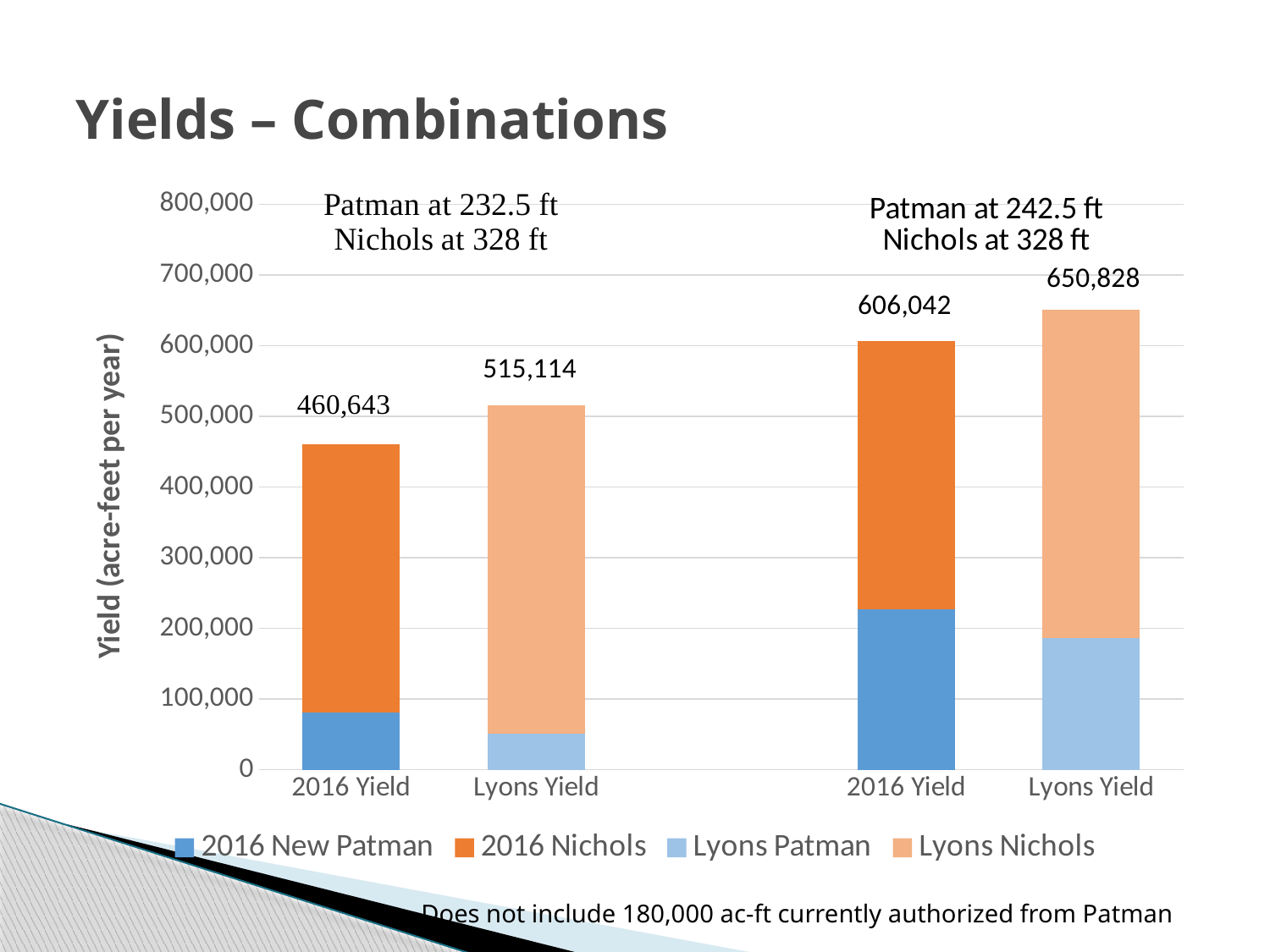
What is the total yield labelled on the 2016 Yield bar under the 'Patman at 232.5 ft, Nichols at 328 ft' scenario? 460,643 How many bars are plotted on the chart? 4 What is the label on the vertical axis? Yield (acre-feet per year) Which bar has the highest total yield? Lyons Yield (Patman at 242.5 ft, Nichols at 328 ft) What is the total yield labelled on the Lyons Yield bar under the 'Patman at 242.5 ft, Nichols at 328 ft' scenario? 650,828 What is the total yield labelled on the 2016 Yield bar under the 'Patman at 242.5 ft, Nichols at 328 ft' scenario? 606,042 Is the 2016 New Patman segment of the 2016 Yield bar under the 'Patman at 242.5 ft' scenario greater or less than 200,000? greater Which bar has the lowest total yield? 2016 Yield (Patman at 232.5 ft, Nichols at 328 ft) What is the difference between the Lyons Yield total and the 2016 Yield total under the 'Patman at 232.5 ft, Nichols at 328 ft' scenario? 54,471 How many series does the legend list? 4 Which is larger: the 2016 Yield total at Patman 242.5 ft or the Lyons Yield total at Patman 232.5 ft? 2016 Yield total at Patman 242.5 ft Is the 2016 New Patman segment of the 2016 Yield bar under the 'Patman at 232.5 ft' scenario greater or less than 100,000? less